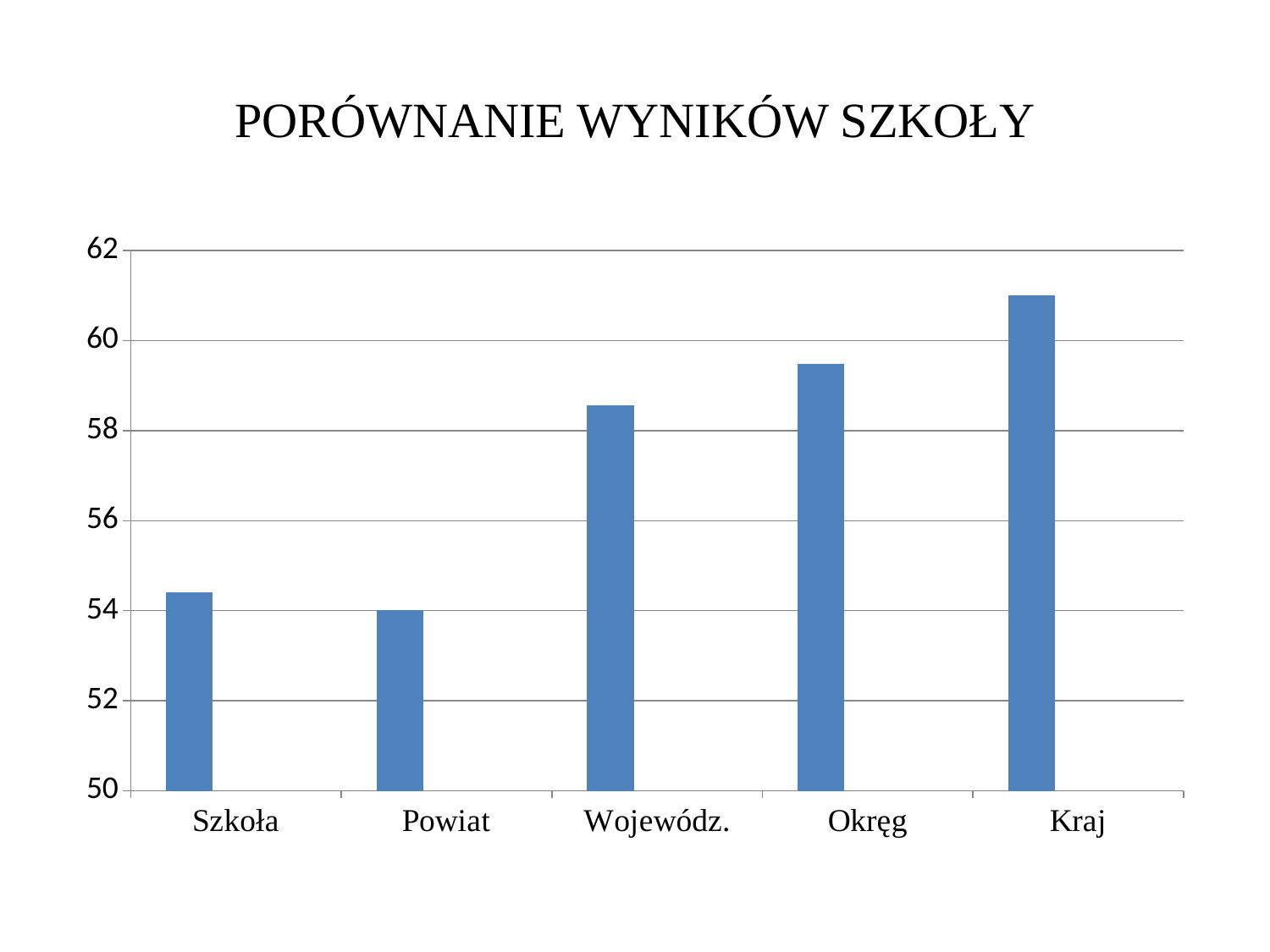
What kind of chart is shown on the slide? bar chart Is the value for Powiat greater or less than 56? less Which category has the highest value in the chart? Kraj Is the value for Wojewódz. greater or less than 58? greater Is the value for Okręg greater or less than 60? less Which has the larger value, Kraj or Szkoła? Kraj Which category has the lowest value in the chart? Powiat Which has the larger value, Okręg or Wojewódz.? Okręg What is the title of the chart on the slide? PORÓWNANIE WYNIKÓW SZKOŁY How many categories are shown on the x axis of the chart? 5